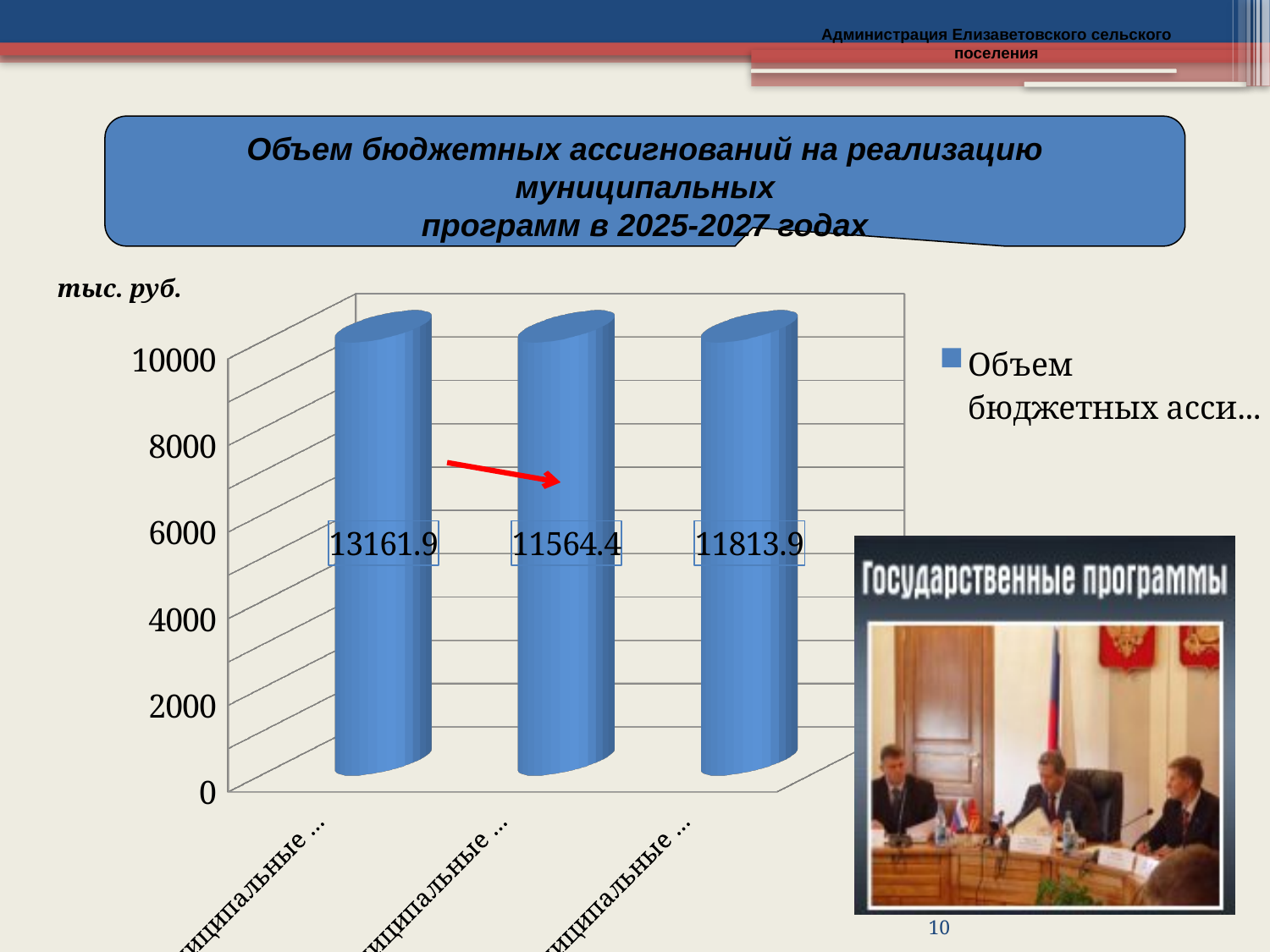
What kind of chart is shown on the slide? bar chart Which is larger, the value of the leftmost bar or the value of the rightmost bar? leftmost bar What is the difference between the rightmost bar's value and the middle bar's value? 249.5 How many series does the chart legend list? 1 What is the value shown on the leftmost bar of the chart? 13161.9 What is the value shown on the rightmost bar of the chart? 11813.9 Which bar has the highest value: the left, middle or right one? left Which bar has the lowest value: the left, middle or right one? middle How many bars are plotted in the chart? 3 What unit is indicated above the vertical axis of the chart? тыс. руб. What is the difference between the leftmost bar's value and the middle bar's value? 1597.5 What is the value shown on the middle bar of the chart? 11564.4